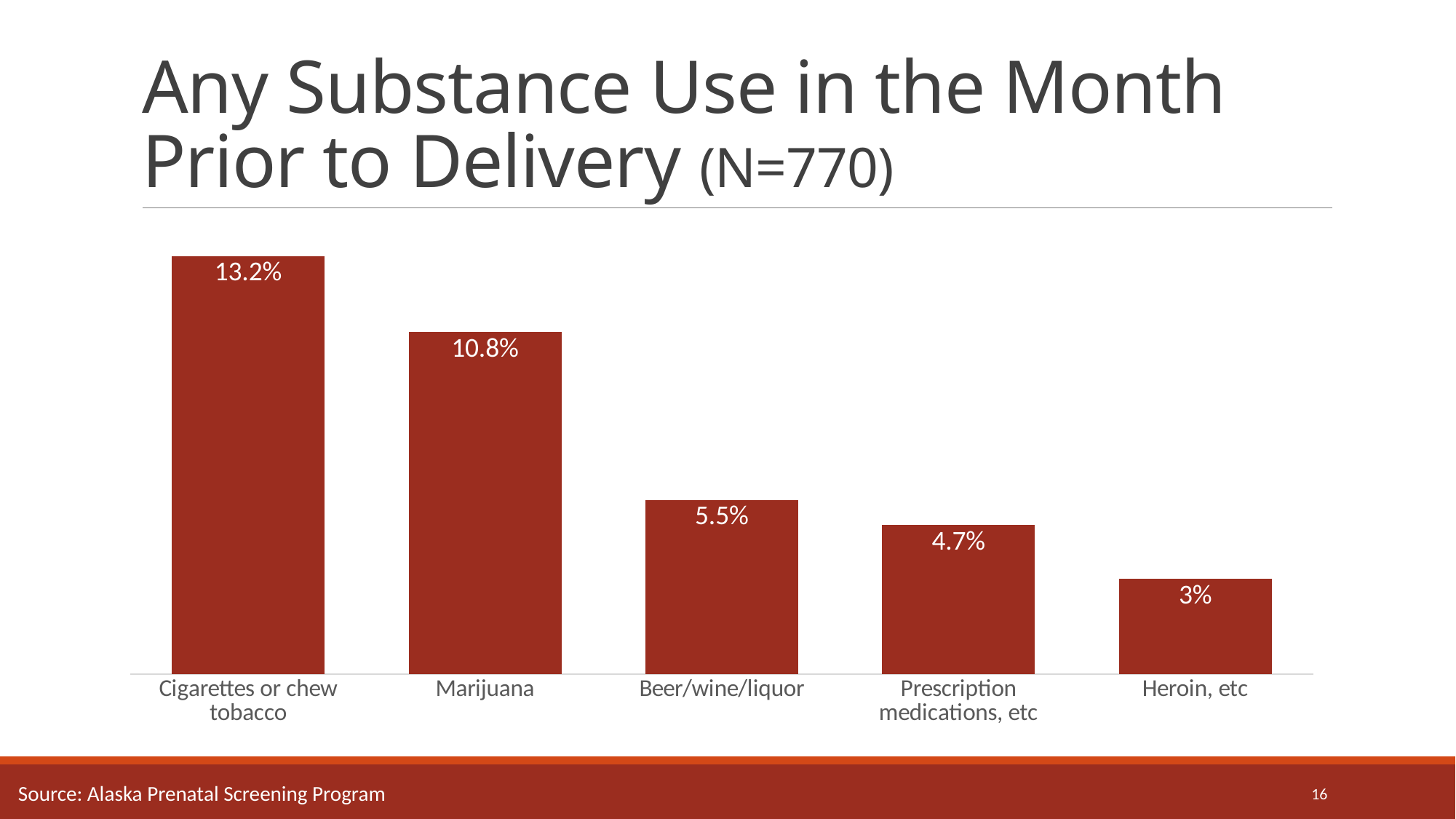
What is the difference between the values for Cigarettes or chew tobacco and Marijuana? 2.4% How many categories are shown in the chart? 5 Which category has the highest value? Cigarettes or chew tobacco Which category has the lowest value? Heroin, etc What is the value for Prescription medications, etc? 4.7% What is the sample size (N) given in the chart title? 770 What kind of chart is shown on the slide? Bar chart What is the value for Beer/wine/liquor? 5.5% Do the values rise or fall from left to right across the categories? Fall What is the value for Heroin, etc? 3% Which is larger, the value for Beer/wine/liquor or the value for Prescription medications, etc? Beer/wine/liquor What is the value for Marijuana? 10.8%